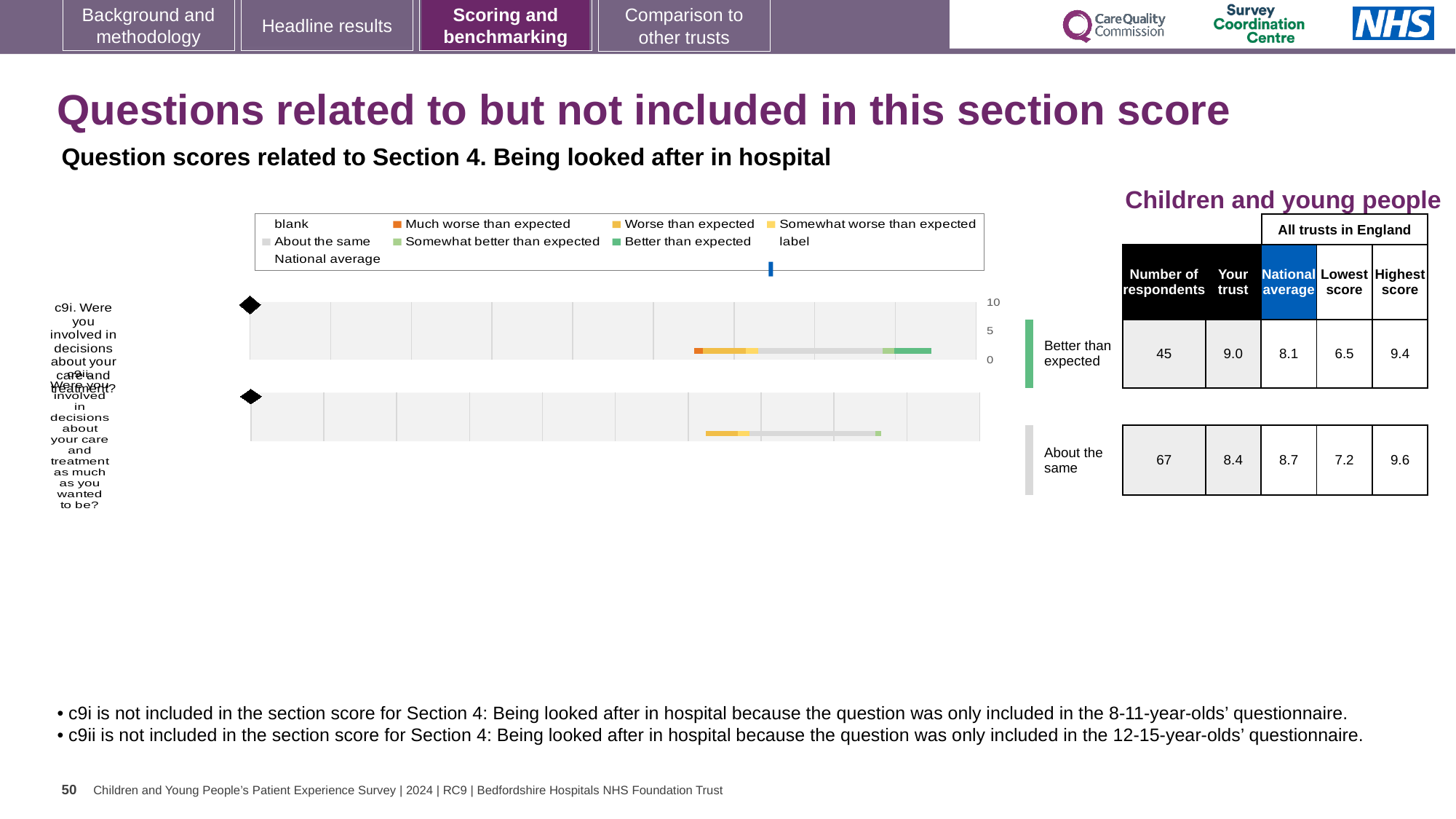
In the table, by how much does the 'Your trust' score exceed the national average for the row rated 'Better than expected'? 0.9 How many entries does the chart legend list? 9 What is the subtitle above the chart describing which section the question scores relate to? Question scores related to Section 4. Being looked after in hospital How many questions (bars) are plotted in the chart? 2 Which row in the table has more respondents, 'Better than expected' or 'About the same'? About the same In the table, what is the national average for the row rated 'Better than expected'? 8.1 In the table, what is the 'Your trust' score for the row rated 'Better than expected'? 9.0 What rating label is shown next to the second bar (c9ii)? About the same In the table, what is the highest score for the row rated 'About the same'? 9.6 In the table, what is the number of respondents for the row rated 'About the same'? 67 What rating label is shown next to the first bar (c9i)? Better than expected What kind of chart is used to show the question scores for c9i and c9ii? bar chart